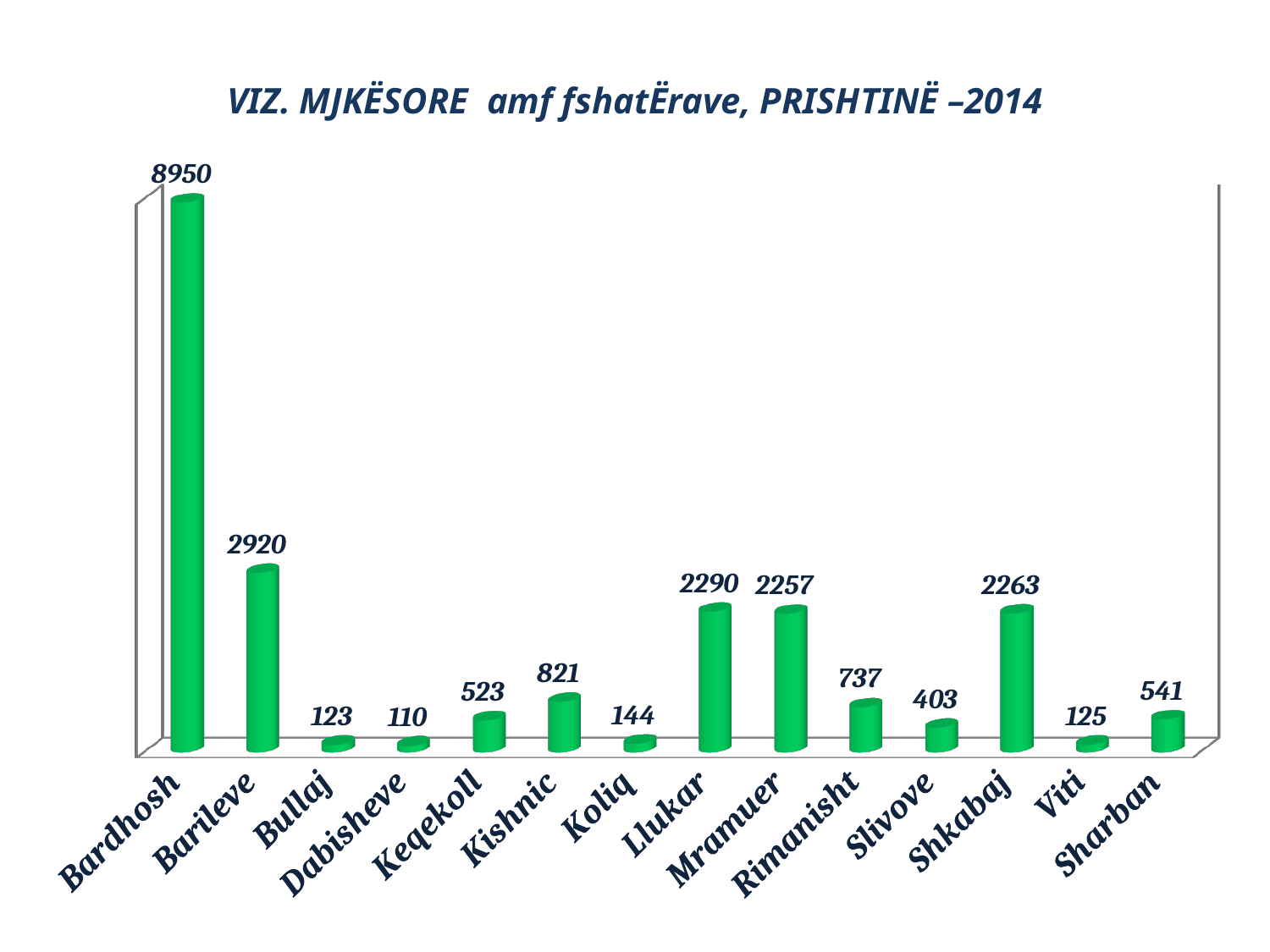
Which category has the lowest value? Dabisheve What is the value for Bardhosh? 8950 What is the value for Kishnic? 821 What kind of chart is shown on the slide? Bar chart What is the difference between the values for Bardhosh and Barileve? 6030 What is the title of the chart? VIZ. MJKËSORE amf fshatËrave, PRISHTINË –2014 What is the difference between the values for Kishnic and Keqekoll? 298 Which category has the highest value? Bardhosh How many categories are shown on the chart? 14 Which is larger, the value for Rimanisht or the value for Sharban? Rimanisht What is the value for Shkabaj? 2263 What is the value for Slivove? 403